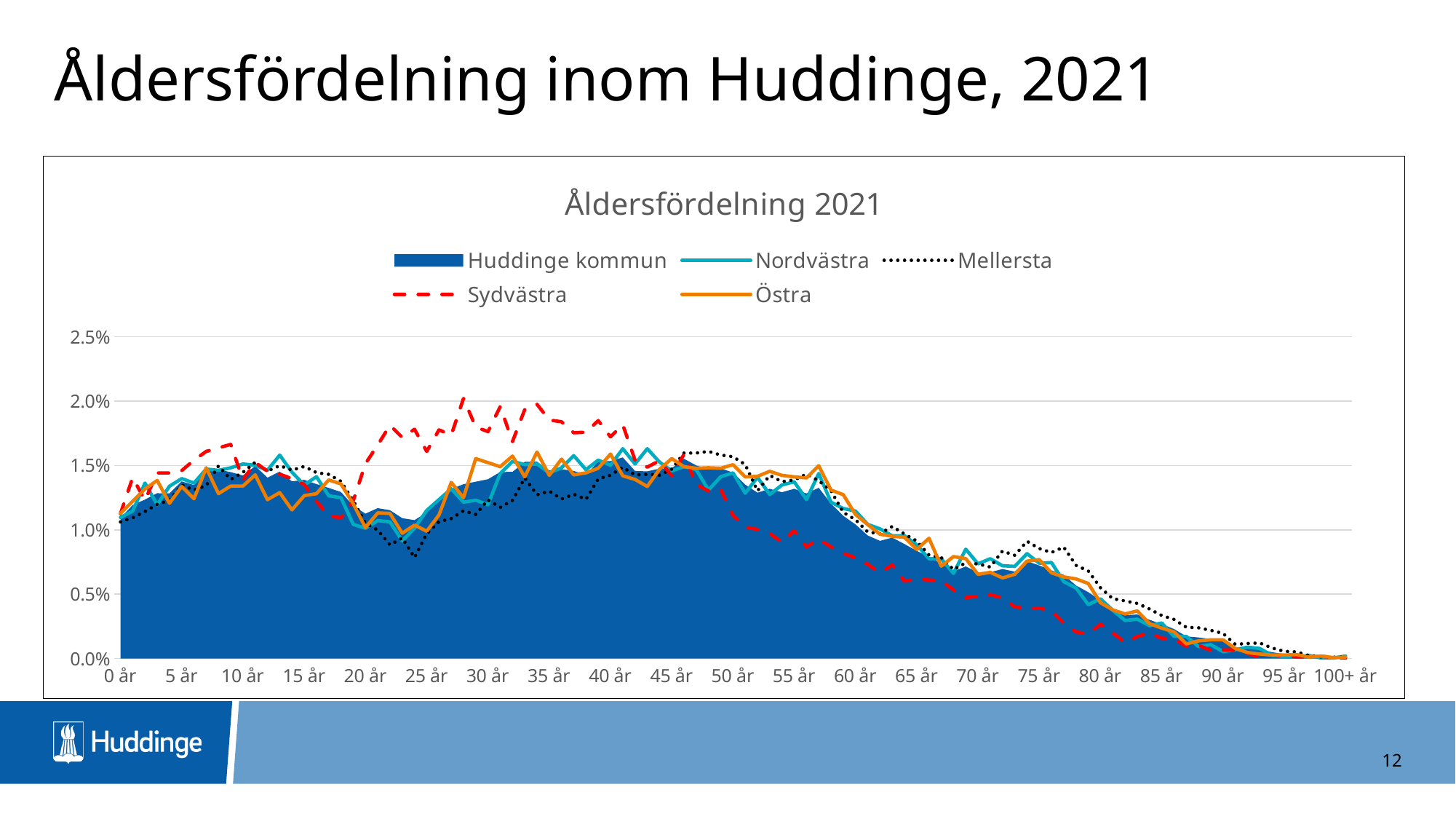
Which series has the highest value at 30 år? Sydvästra Which series has the lowest value at 75 år? Sydvästra Which series is drawn as a red dashed line? Sydvästra Do the values for Huddinge kommun rise or fall from 60 år to 100+ år? fall What is the title of the chart? Åldersfördelning 2021 At 25 år, which series has the larger value, Sydvästra or Huddinge kommun? Sydvästra Is the value for Sydvästra at 30 år greater or less than 1.5%? greater Is the value for Sydvästra at 70 år greater or less than 1.0%? less What kind of chart is shown on the slide? area and line chart Is the value for Huddinge kommun at 25 år greater or less than 1.5%? less How many series does the legend of the chart list? 5